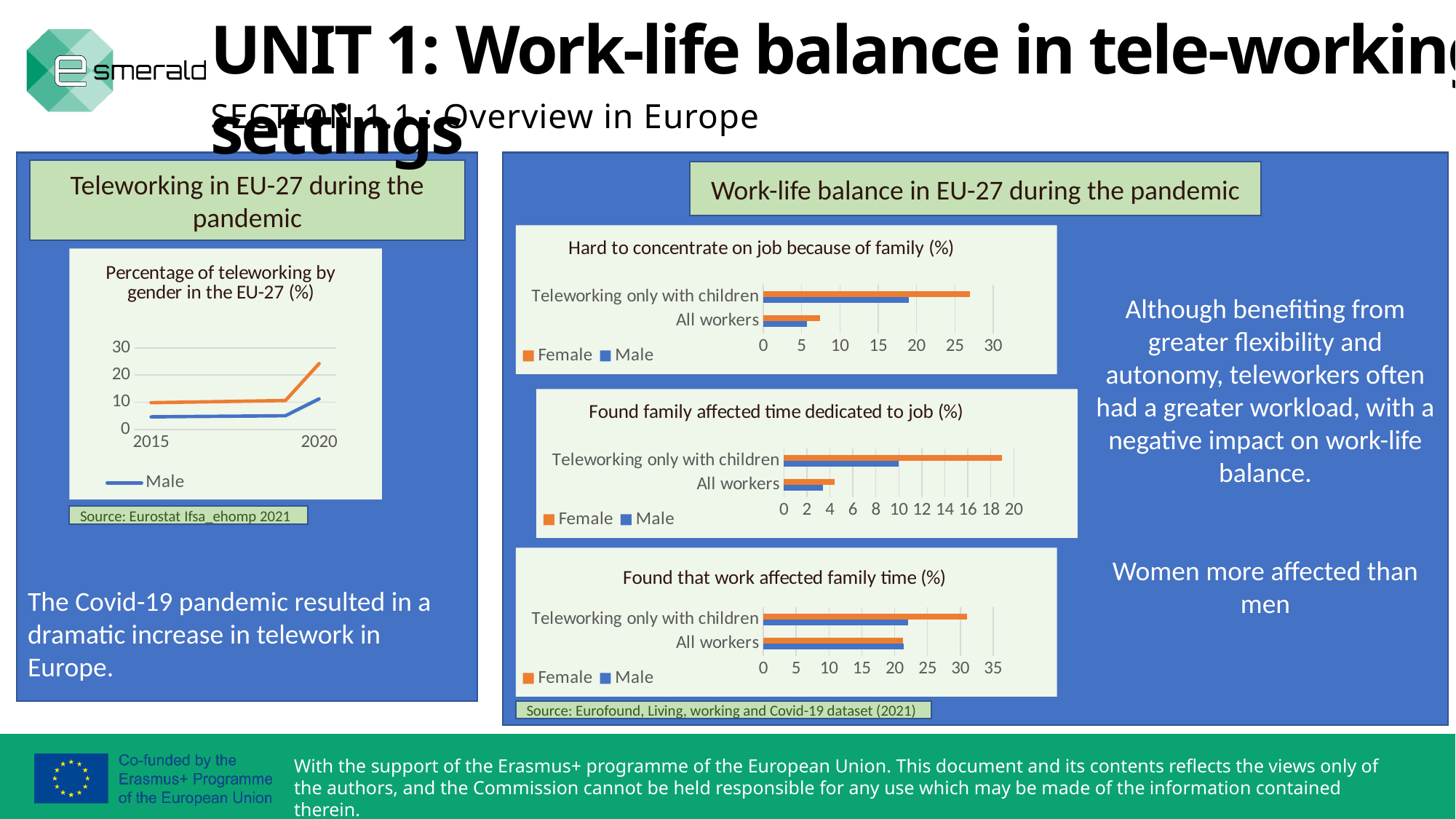
In the chart "Found family affected time dedicated to job (%)", which is larger for "Teleworking only with children": Female or Male? Female How many categories are shown in the chart "Found that work affected family time (%)"? 2 How many series does the legend of "Hard to concentrate on job because of family (%)" list? 2 In the chart "Percentage of teleworking by gender in the EU-27 (%)", is the value of the blue (Male) line in 2015 greater or less than 10? less In the chart "Found family affected time dedicated to job (%)", is the Female value for "Teleworking only with children" greater or less than 16? greater What kind of chart is "Percentage of teleworking by gender in the EU-27 (%)"? line chart In the chart "Hard to concentrate on job because of family (%)", is the Female value for "All workers" greater or less than 10? less In the chart "Percentage of teleworking by gender in the EU-27 (%)", do the lines rise or fall from 2015 to 2020? rise What kind of chart is "Hard to concentrate on job because of family (%)"? bar chart